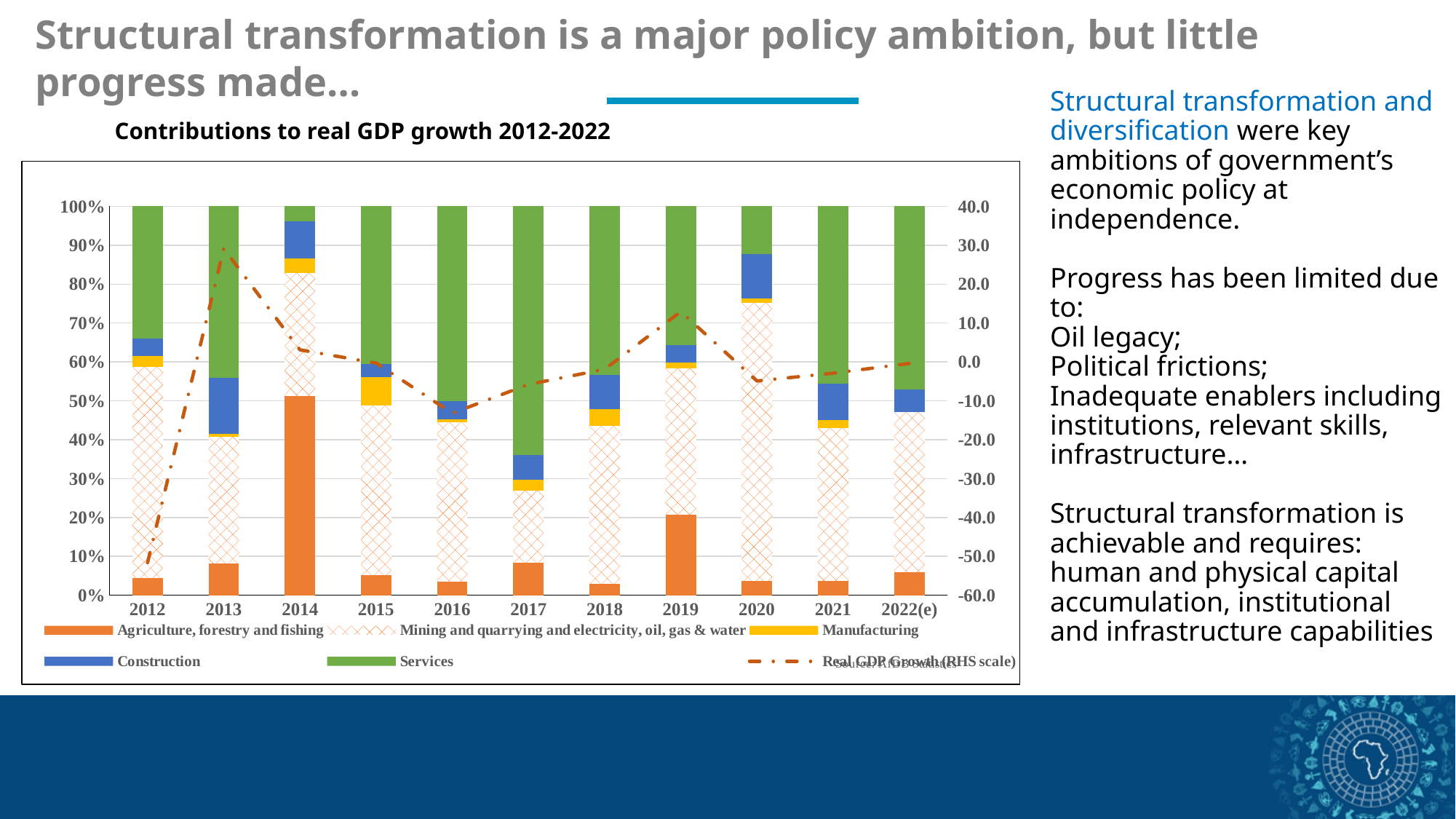
Is the share of Agriculture, forestry and fishing in 2014 greater or less than 40%? greater What kind of chart is shown on the slide? Stacked bar chart with a line In which year is the share of Agriculture, forestry and fishing the largest? 2014 How many years are shown along the x axis of the chart? 11 Which series is plotted as a dashed line on the right-hand scale? Real GDP Growth (RHS scale) In which year does the Real GDP Growth line reach its highest point? 2013 Which year has the larger share of Agriculture, forestry and fishing, 2013 or 2019? 2019 Is the Real GDP Growth value for 2012 greater or less than -40.0? less In which year does the Real GDP Growth line reach its lowest point? 2012 What is the title of the chart? Contributions to real GDP growth 2012-2022 In which year is the share of Services the smallest? 2014 How many series does the chart's legend list? 6